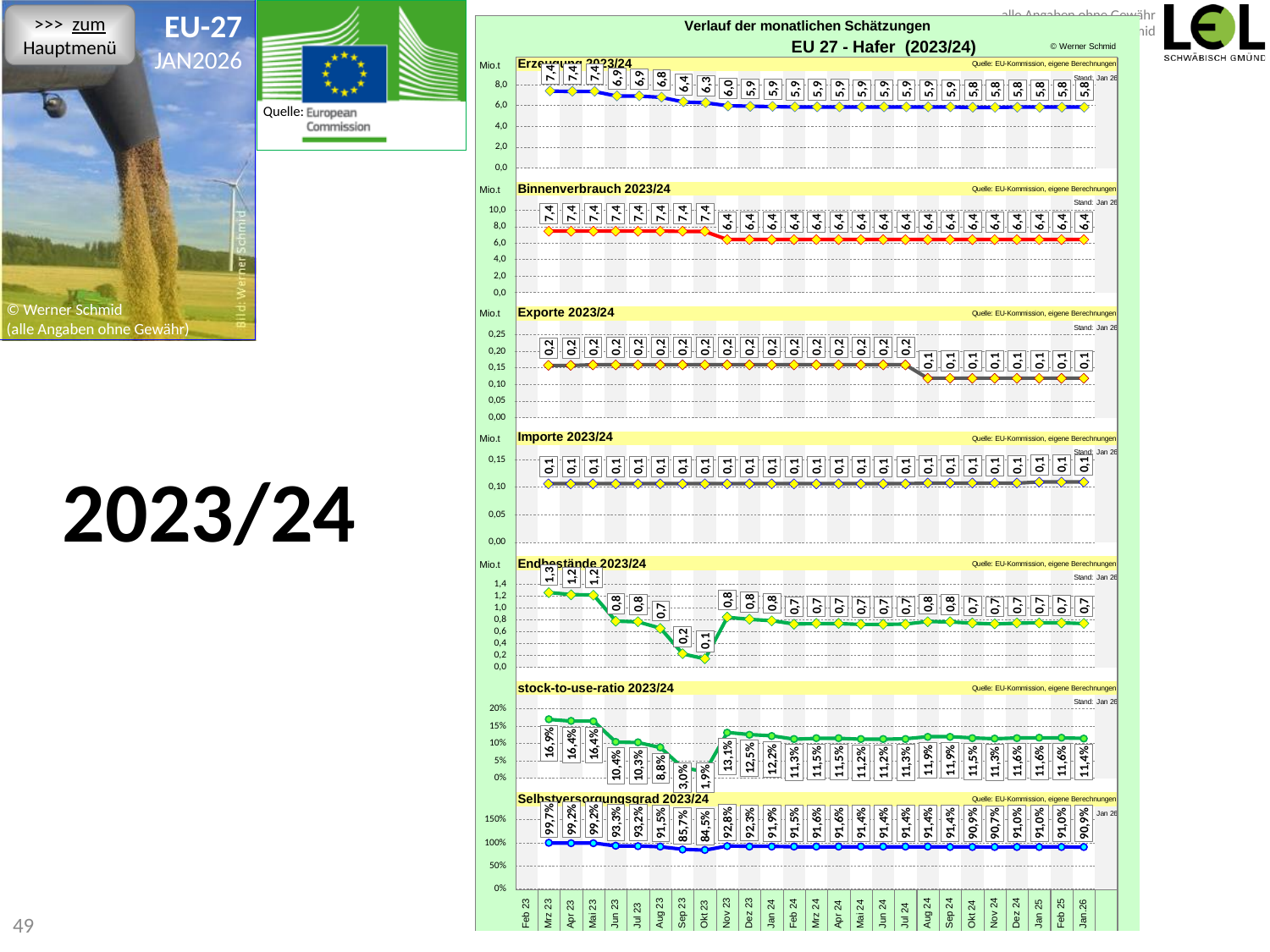
In the Endbestände 2023/24 chart, what is the highest value shown? 1,3 In the Endbestände 2023/24 chart, what is the lowest value shown? 0,1 In the Exporte 2023/24 chart, what is the value for Jan 26? 0,1 In the stock-to-use-ratio 2023/24 chart, what is the value for Jan 26? 11,4% In the Erzeugung 2023/24 chart, do the values rise or fall from Feb 23 to Jan 26? fall In the Binnenverbrauch 2023/24 chart, what is the difference between the Feb 23 value and the Jan 26 value? 1,0 In the Selbstversorgungsgrad 2023/24 chart, which is larger: the value for Feb 23 or the value for Jan 26? Feb 23 In the Erzeugung 2023/24 chart, what is the value for Jan 26? 5,8 What kind of chart is used in the Erzeugung 2023/24 panel? line chart Which commodity and region does the chart panel's title refer to? EU 27 - Hafer (2023/24) In the Importe 2023/24 chart, what is the value for Feb 23? 0,1 In the Erzeugung 2023/24 chart, what is the value for Feb 23? 7,4